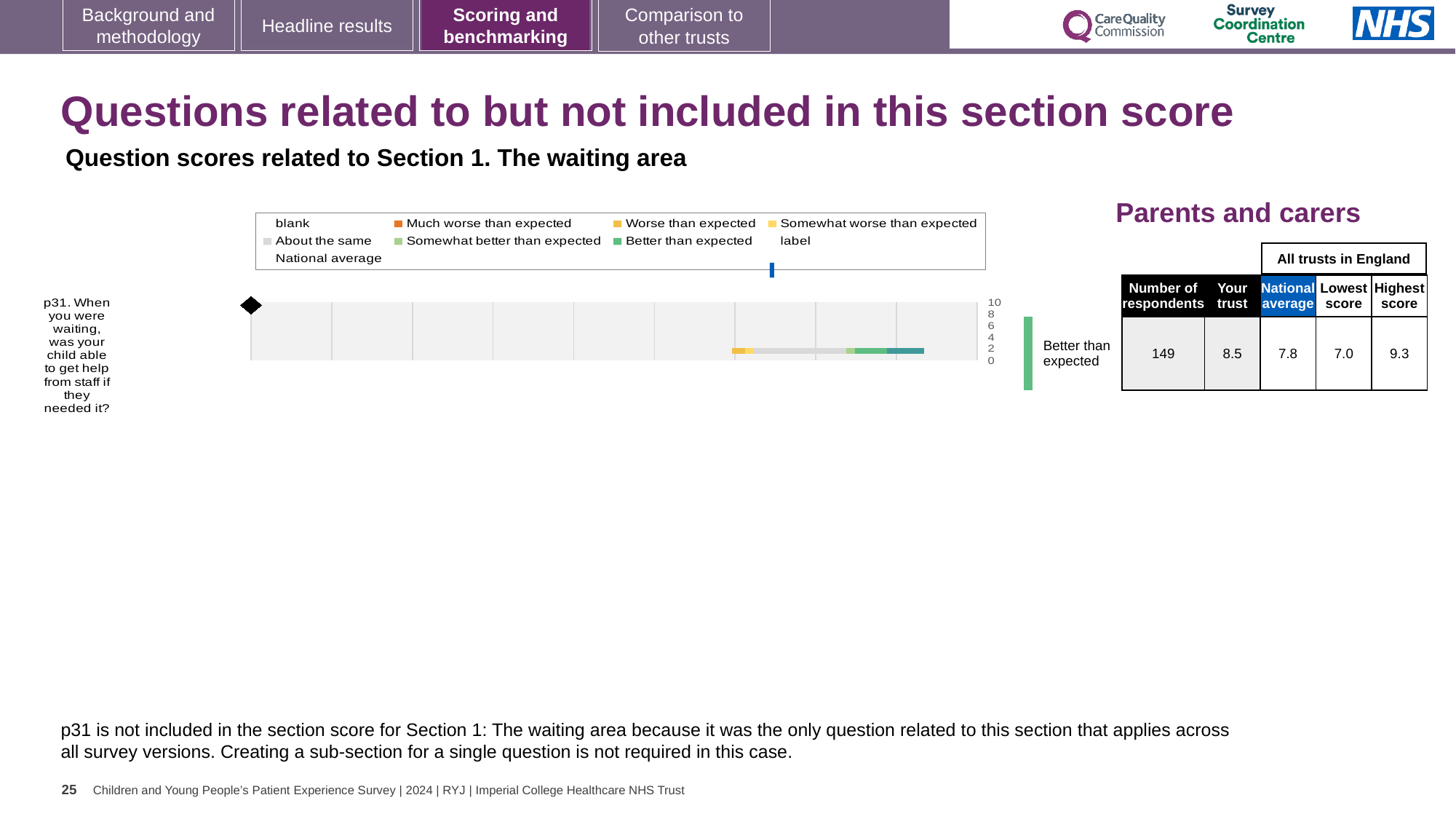
What is the difference between the 'Your trust' score and the national average for p31? 0.7 Which is larger for p31: the 'Your trust' score or the national average? Your trust Which benchmark category is shown to the right of the bar for p31? Better than expected What is the lowest score among all trusts in England for p31? 7.0 How many respondents answered p31? 149 What kind of chart is used to show the p31 question score? Bar chart What is the difference between the highest and lowest scores among all trusts in England for p31? 2.3 What is the 'Your trust' score for p31? 8.5 What is the highest value shown on the chart's score axis? 10 How many questions are plotted in the chart? 1 What is the national average score for p31? 7.8 What is the highest score among all trusts in England for p31? 9.3